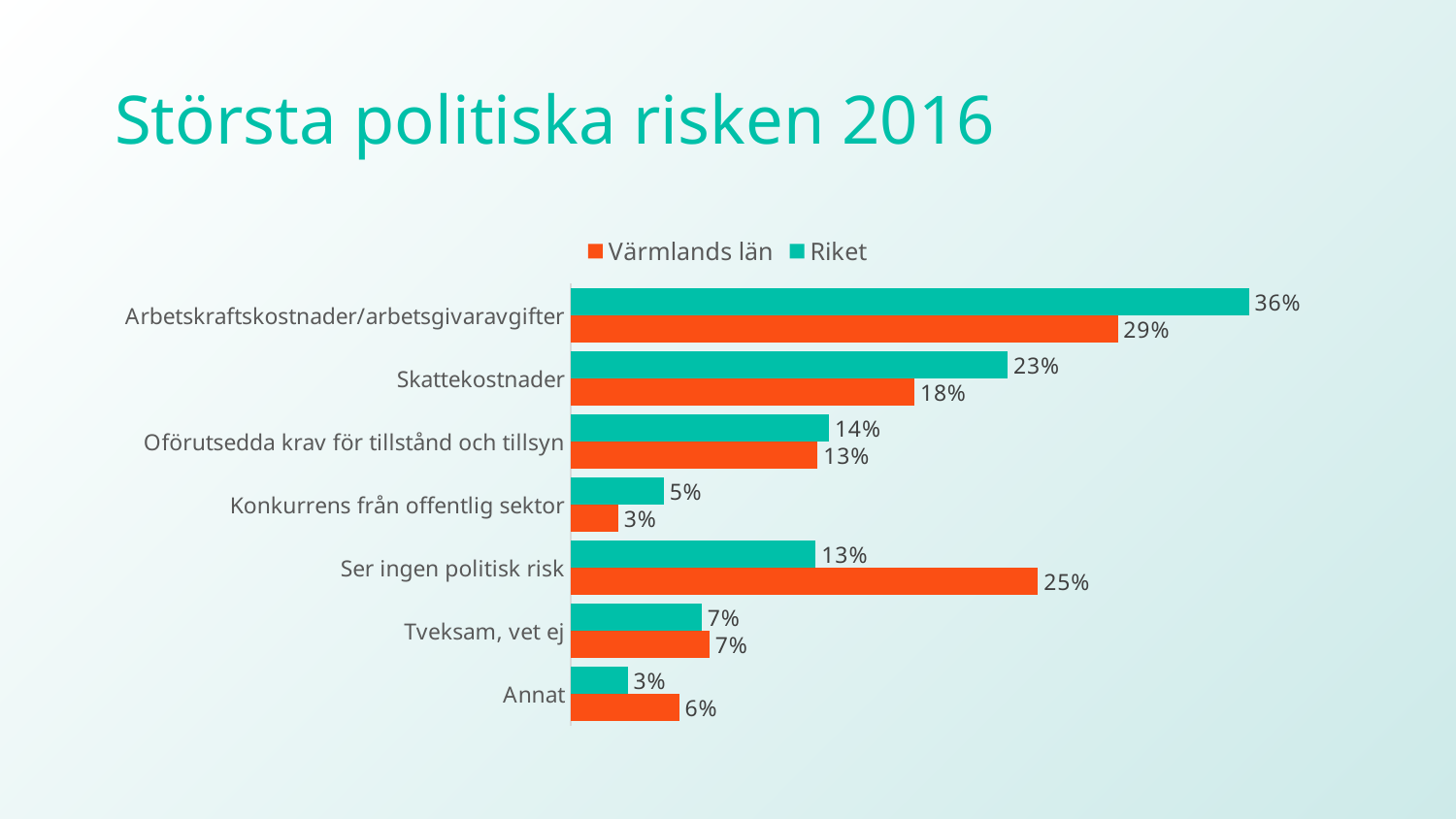
What is the value for Värmlands län in the Skattekostnader category? 18% What is the value for Värmlands län in the Ser ingen politisk risk category? 25% Which category has the lowest value for Riket? Annat Which is larger for Konkurrens från offentlig sektor: the Riket value or the Värmlands län value? Riket Which is larger for Annat: the Värmlands län value or the Riket value? Värmlands län What type of chart is shown on the slide? Bar chart How many series does the legend list? 2 What is the difference between the Värmlands län and Riket values for Ser ingen politisk risk? 12 percentage points How many categories are shown in the chart? 7 What is the difference between the Riket and Värmlands län values for Skattekostnader? 5 percentage points What is the value for Riket in the Arbetskraftskostnader/arbetsgivaravgifter category? 36% Which category has the highest value for Riket? Arbetskraftskostnader/arbetsgivaravgifter